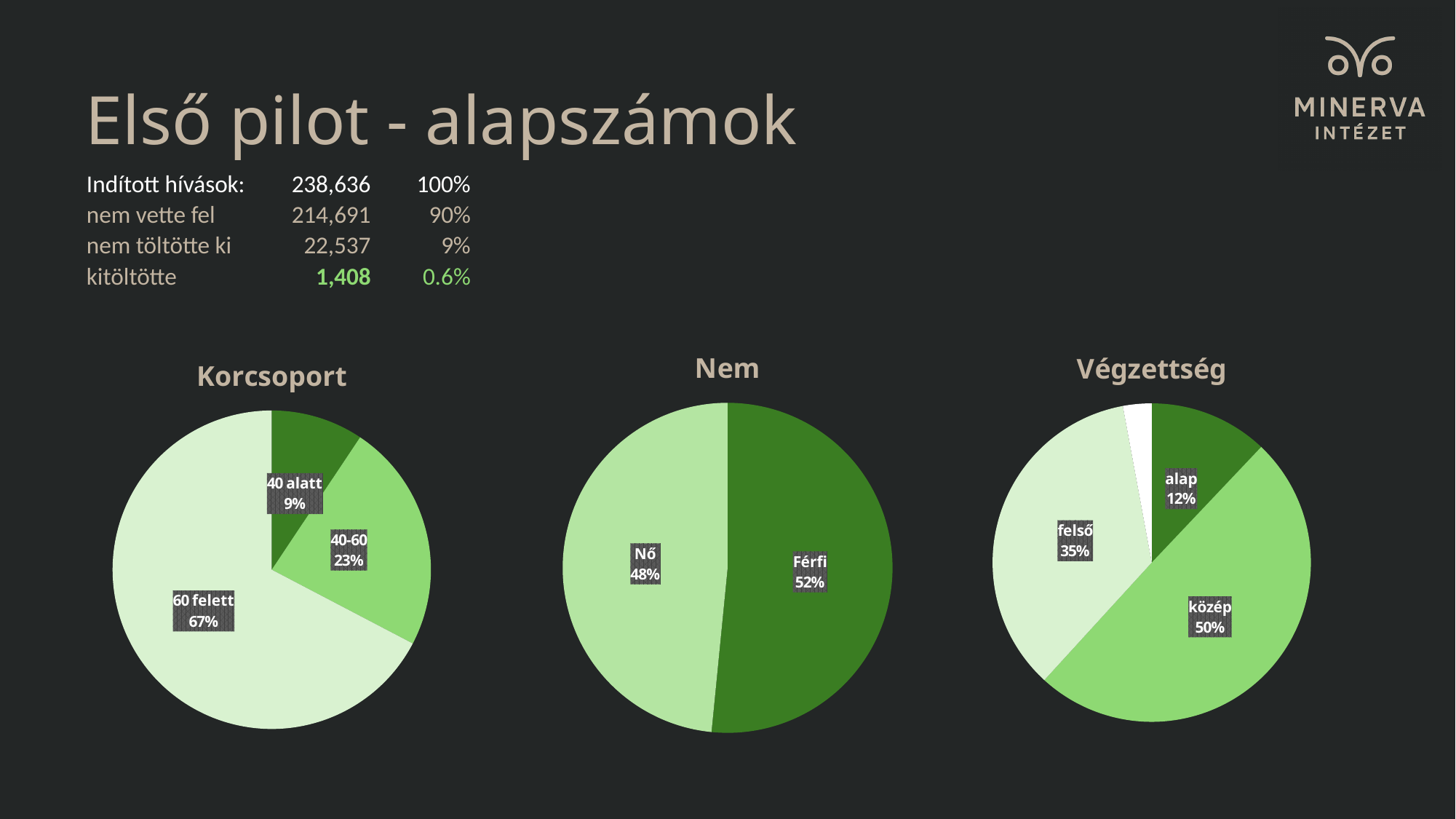
In the Korcsoport chart, what is the value for 40-60? 23% In the Nem chart, what is the share for Férfi? 52% In the Végzettség chart, what is the difference in percentage points between felső and alap? 23 In the Korcsoport chart, which category has the smallest share? 40 alatt How many slices does the Korcsoport pie chart have? 3 What type of chart is used for Korcsoport, Nem and Végzettség? Pie chart In the Korcsoport chart, what share does the 60 felett slice have? 67% In the Nem chart, what is the difference in percentage points between Férfi and Nő? 4 In the Korcsoport chart, what is the difference in percentage points between 60 felett and 40-60? 44 In the Végzettség chart, which labeled category has the largest share? közép In the Végzettség chart, what is the share for közép? 50% In the Nem chart, which is larger, Nő or Férfi? Férfi